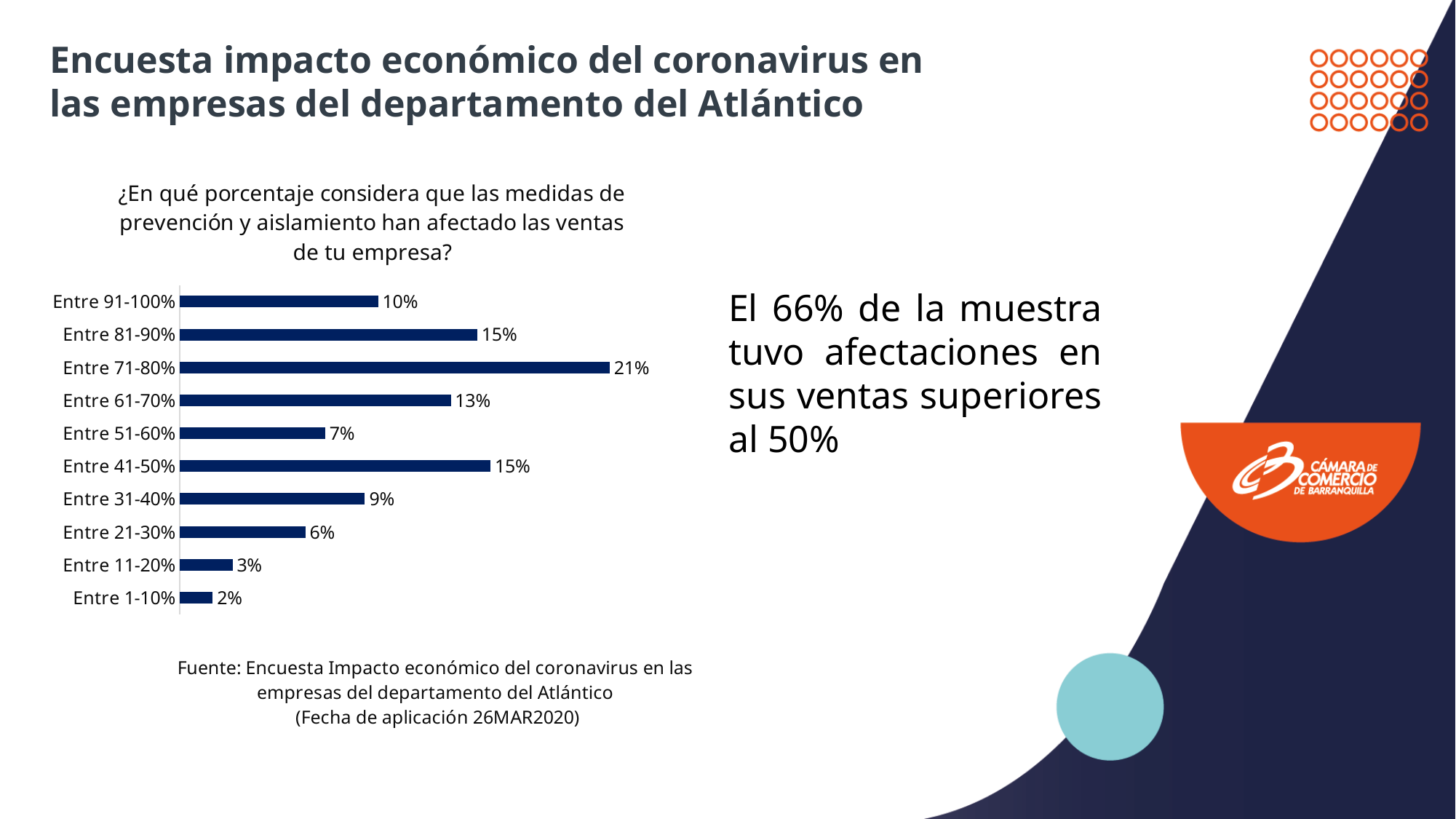
Which category has the lowest value? Entre 1-10% Which category has the highest value? Entre 71-80% What is the value for the category "Entre 71-80%"? 21% What is the difference between the values for "Entre 71-80%" and "Entre 61-70%"? 8% Which is larger, the value for "Entre 31-40%" or the value for "Entre 51-60%"? Entre 31-40% What is the value for the category "Entre 91-100%"? 10% How many categories are shown in the chart? 10 What is the difference between the values for "Entre 21-30%" and "Entre 11-20%"? 3% What kind of chart is shown on the slide? Bar chart What is the value for the category "Entre 41-50%"? 15% What question does the chart title ask? ¿En qué porcentaje considera que las medidas de prevención y aislamiento han afectado las ventas de tu empresa? What is the value for the category "Entre 1-10%"? 2%